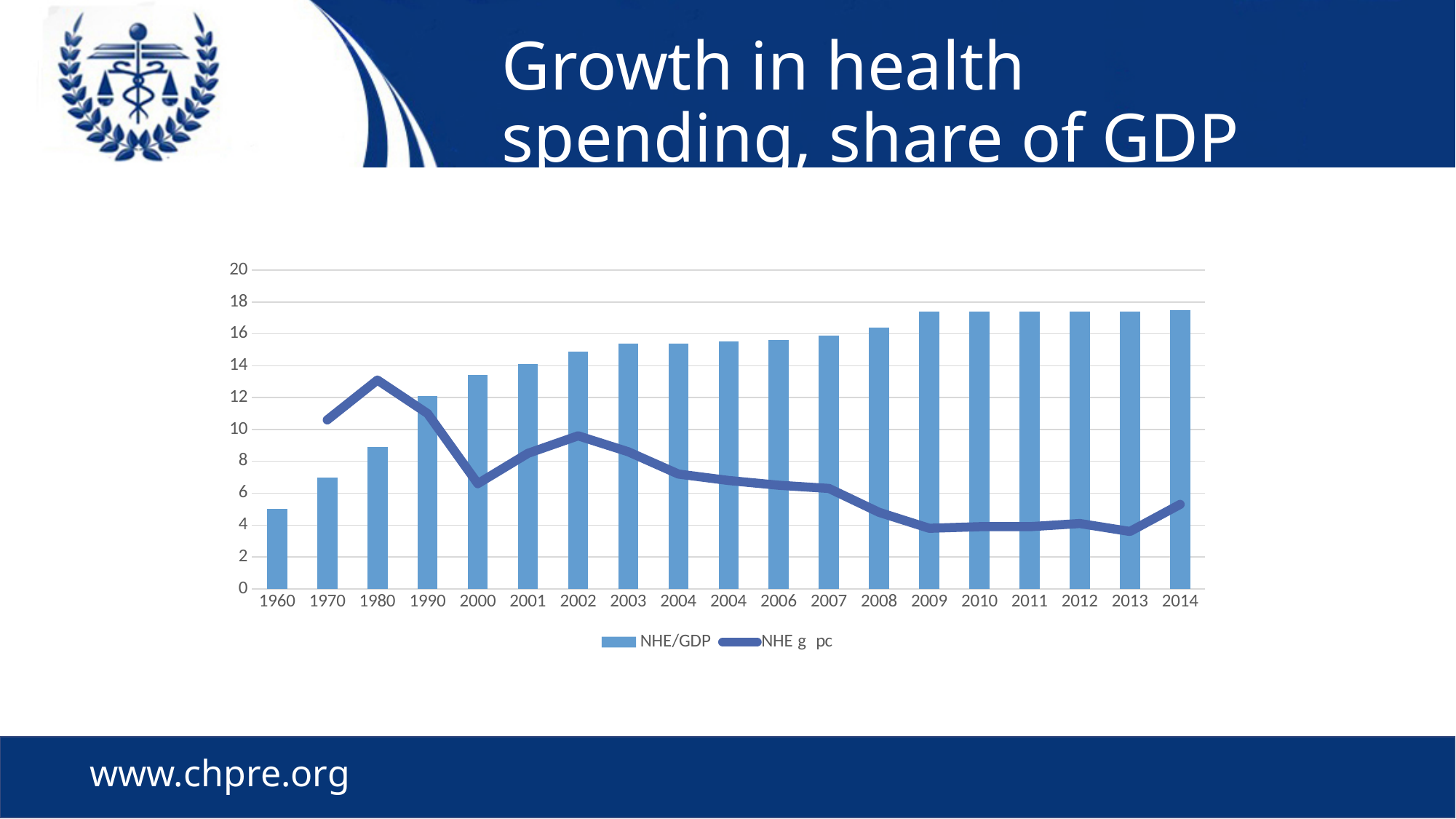
How many series does the legend list? 2 Is the NHE/GDP value for 2014 greater or less than 16? greater Which year has the lowest NHE/GDP bar? 1960 What kind of chart is shown on the slide? A combined bar and line chart How many year categories are shown on the x axis? 19 Which is larger, the NHE/GDP bar for 1990 or for 2000? 2000 Is the NHE g pc value for 2000 greater or less than 8? less Is the NHE g pc value for 1980 greater or less than 12? greater What are the two legend entries of the chart? NHE/GDP and NHE g pc In which year does the NHE g pc line reach its highest point? 1980 Do the NHE/GDP bars generally rise or fall from 1960 to 2014? rise